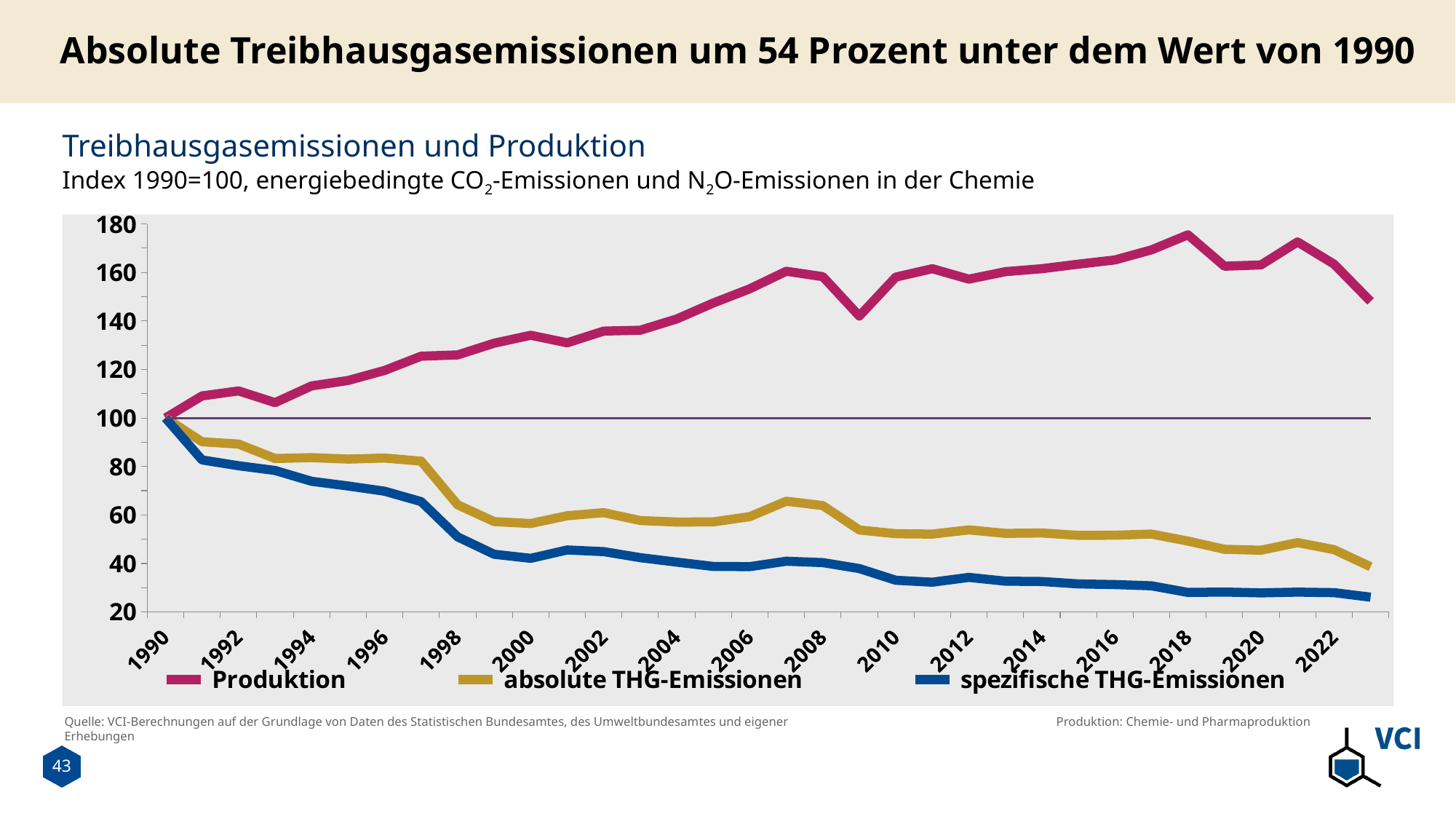
In 2010, which is larger: Produktion or absolute THG-Emissionen? Produktion In 2022, which is larger: absolute THG-Emissionen or spezifische THG-Emissionen? absolute THG-Emissionen What colour is the Produktion line in the legend? magenta/pink What kind of chart is shown on the slide? line chart How many series does the legend list? 3 Is the value for absolute THG-Emissionen in 2022 greater or less than 60? less Does the spezifische THG-Emissionen line rise or fall from 1990 to 2022? fall Is the value for spezifische THG-Emissionen in 2022 greater or less than 40? less Is the value for Produktion in 2018 greater or less than 160? greater What is the index value of Produktion in 1990? 100 Which series has the highest value in 2022? Produktion